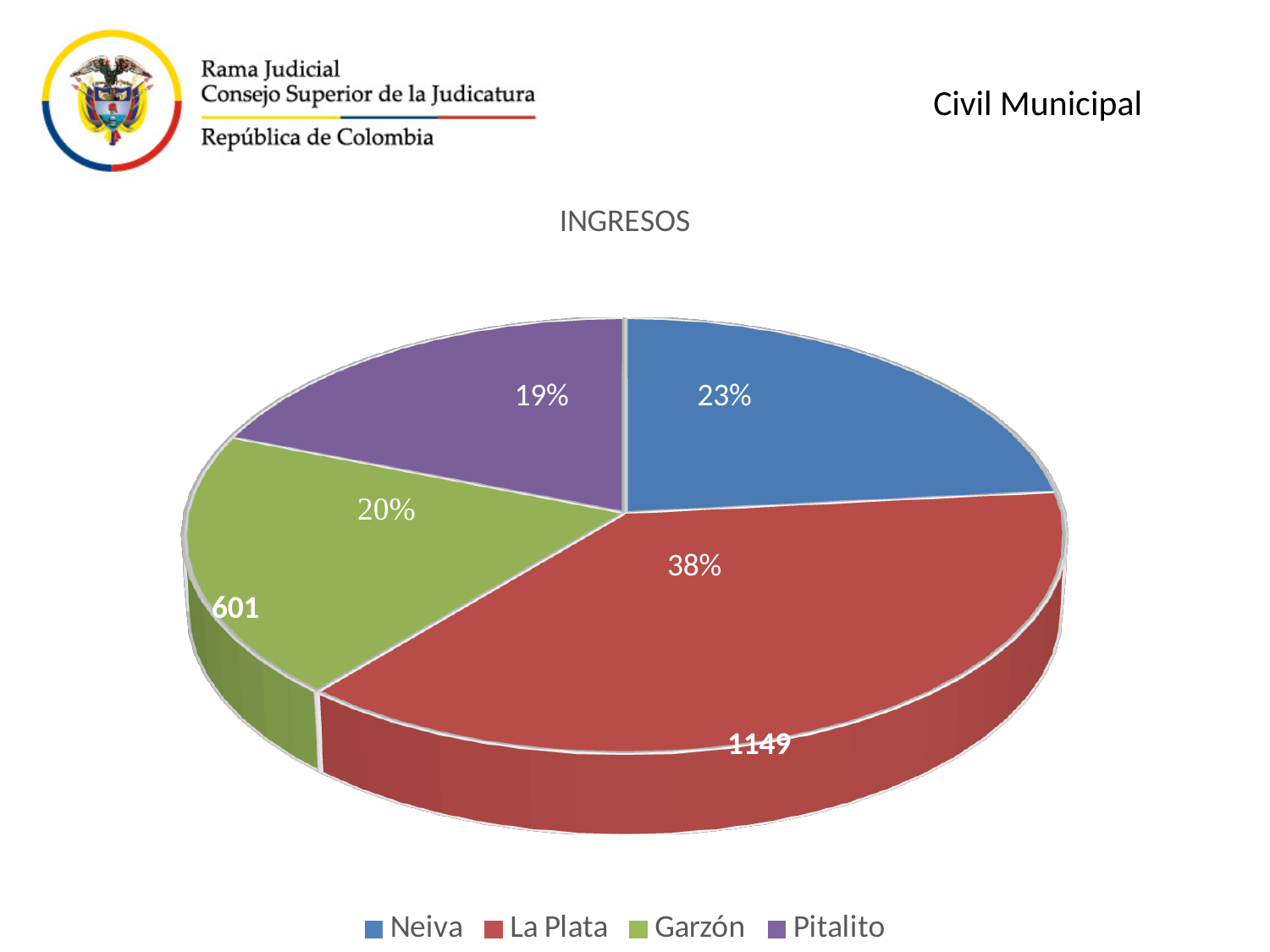
Which category has the largest slice in the INGRESOS pie chart? La Plata Which category has the smallest slice in the INGRESOS pie chart? Pitalito What is the difference in percentage points between La Plata's share and Neiva's share in the INGRESOS pie? 15 percentage points Which has a larger share of the INGRESOS pie, Neiva or Garzón? Neiva What share of the INGRESOS pie does Pitalito represent? 19% What share of the INGRESOS pie does Neiva represent? 23% What kind of chart is shown on the slide? Pie chart How many slices does the INGRESOS pie chart have? 4 What colour is the La Plata slice in the INGRESOS pie chart? Red What share of the INGRESOS pie does La Plata represent? 38% How many entries does the legend of the INGRESOS chart list? 4